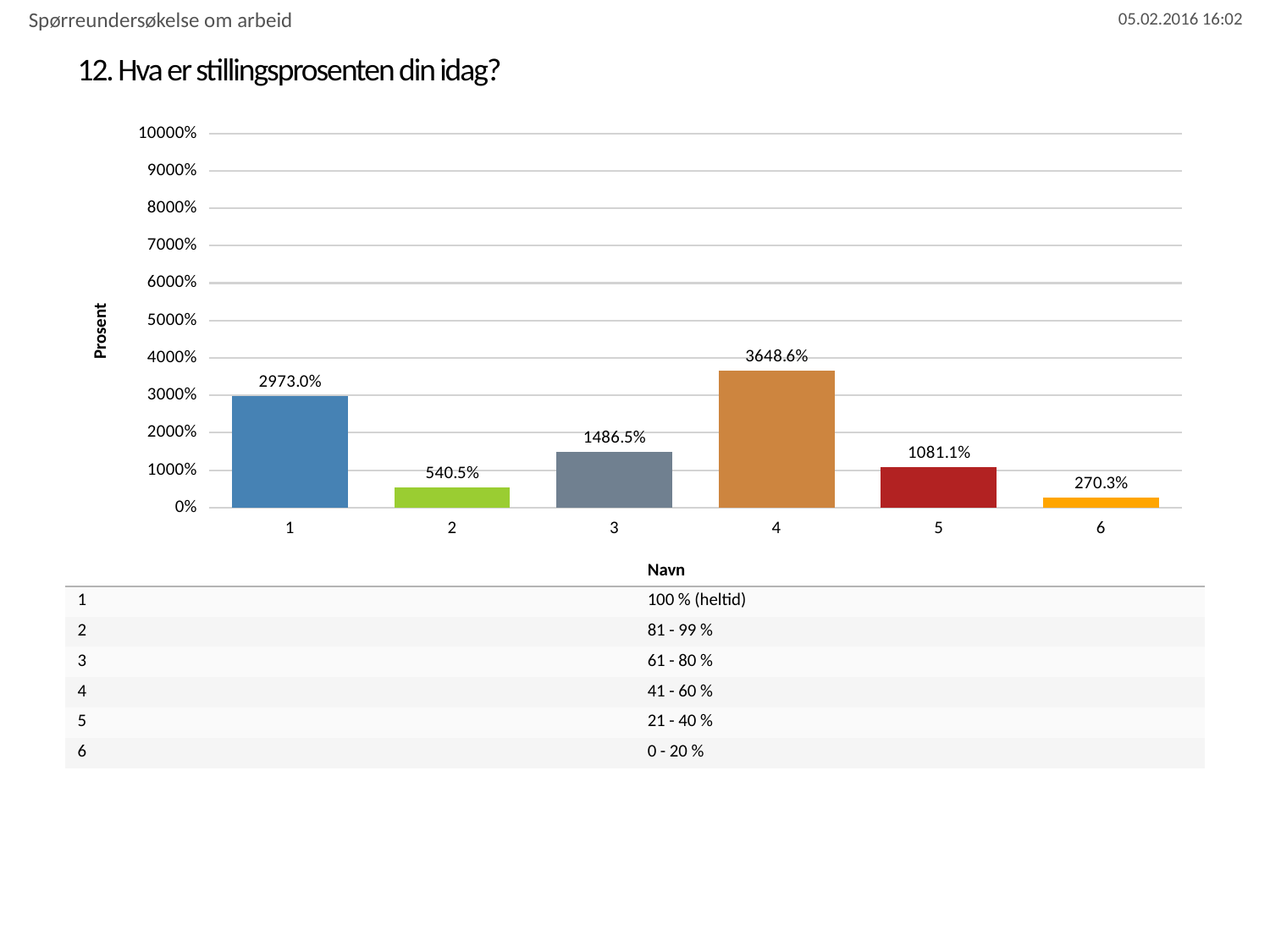
What kind of chart is shown on the slide? bar chart Which is larger, the value for category 2 or category 5? 5 What is the value for category 3? 1486.5% What is the difference between the values for category 4 and category 1? 675.6% What is the value for category 4? 3648.6% Which category has the highest value? 4 How many categories are shown in the chart? 6 What is the label of the y axis? Prosent What is the value for category 1? 2973.0% What is the value for category 6? 270.3% Which category has the lowest value? 6 Is the value for category 3 greater or less than 1000%? greater